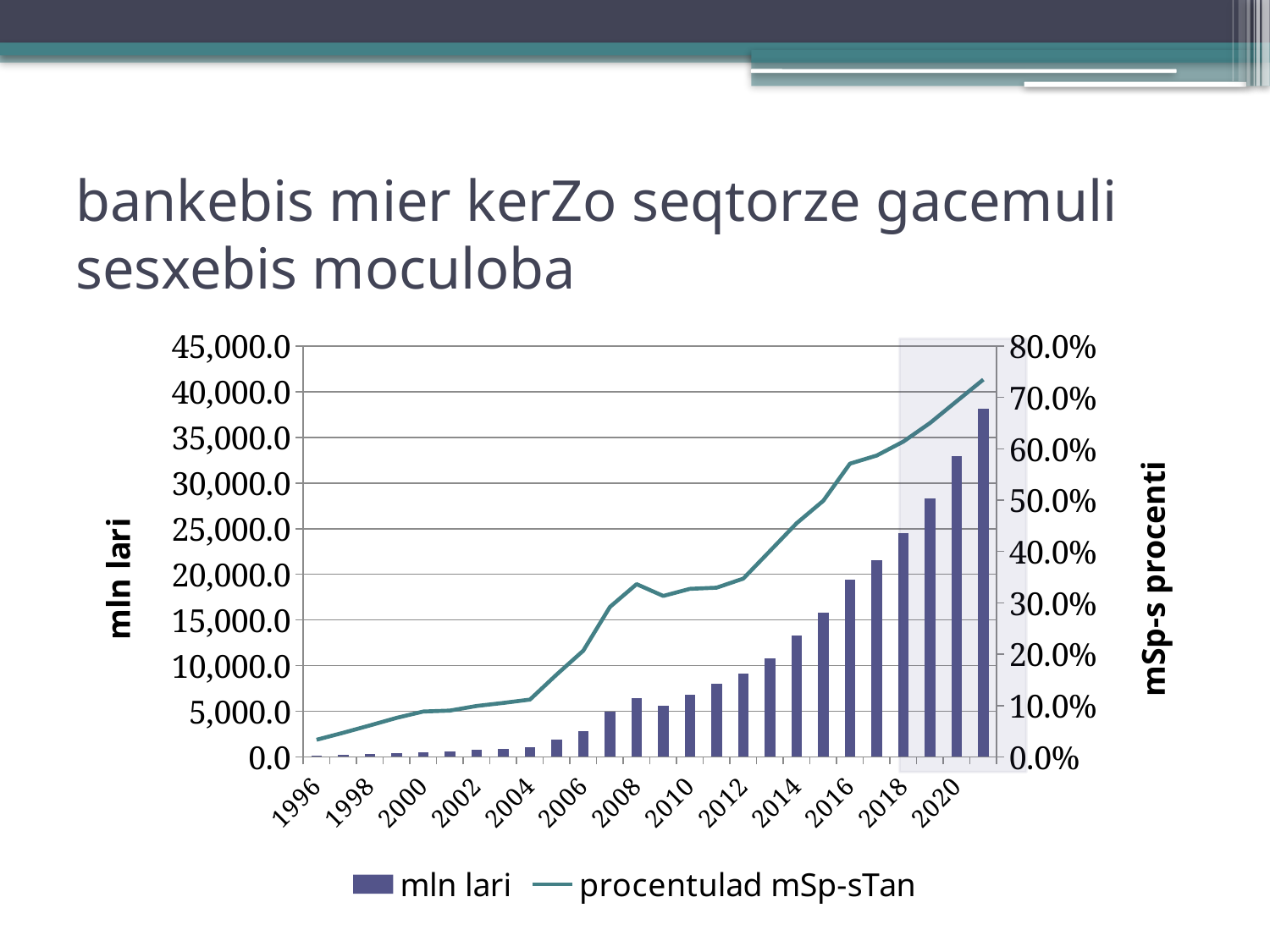
Which year has the larger mln lari bar, 2012 or 2018? 2018 Which year has the lowest mln lari bar? 1996 Is the mln lari value for 2016 greater or less than 20,000.0? less How many series does the legend list? 2 Is the procentulad mSp-sTan value for 2016 greater or less than 50.0%? greater What are the two series named in the legend? mln lari and procentulad mSp-sTan What kind of chart is shown on the slide? A combined bar and line chart What is the label of the left vertical axis? mln lari Is the mln lari value for 2020 greater or less than 30,000.0? greater Do the mln lari bars generally rise or fall from 1996 to 2020? Rise Does the procentulad mSp-sTan line generally rise or fall across the years shown? Rise